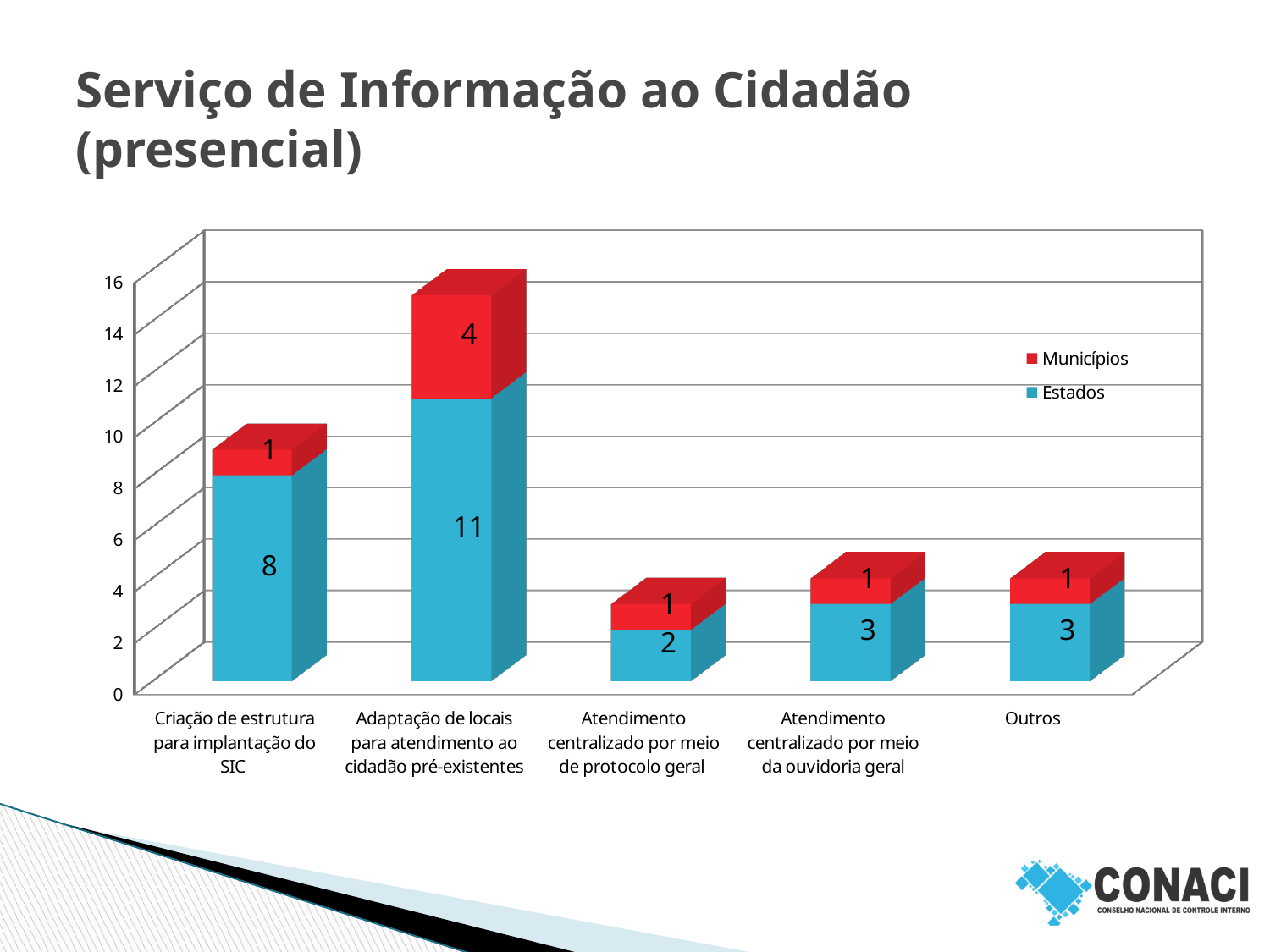
What is the total of the stacked bar for "Adaptação de locais para atendimento ao cidadão pré-existentes"? 15 How many categories are shown on the x axis? 5 What is the Estados value for "Atendimento centralizado por meio de protocolo geral"? 2 What is the Municípios value for "Criação de estrutura para implantação do SIC"? 1 What is the difference between the Estados values for "Adaptação de locais para atendimento ao cidadão pré-existentes" and "Criação de estrutura para implantação do SIC"? 3 What kind of chart is shown on the slide? Stacked bar chart What is the Estados value for "Adaptação de locais para atendimento ao cidadão pré-existentes"? 11 Which category has the highest Estados value? Adaptação de locais para atendimento ao cidadão pré-existentes What is the total of the stacked bar for "Criação de estrutura para implantação do SIC"? 9 Which is larger: the Estados value for "Outros" or the Estados value for "Atendimento centralizado por meio de protocolo geral"? Outros Which category has the lowest Estados value? Atendimento centralizado por meio de protocolo geral How many series does the legend list? 2